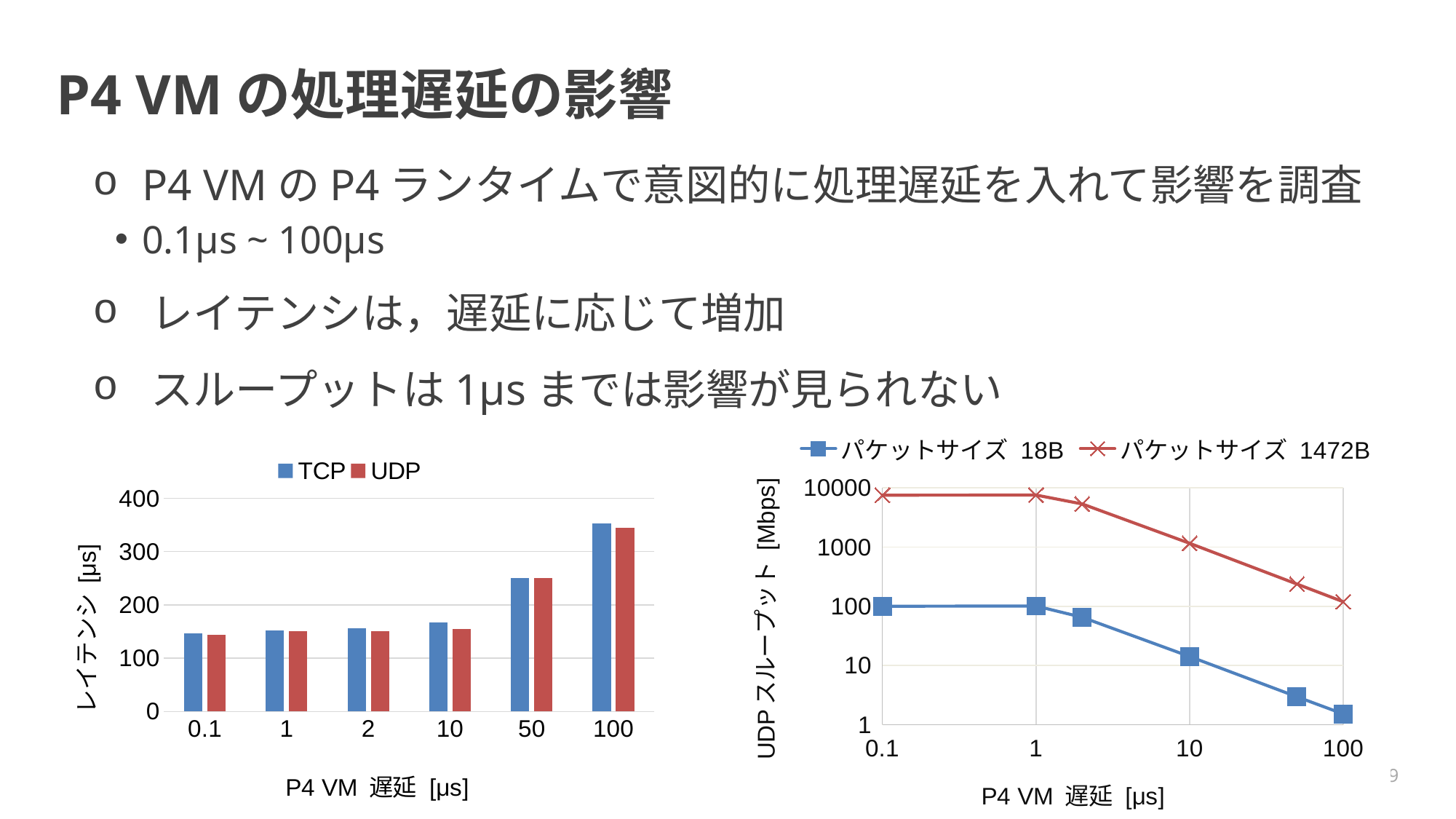
What kind of chart is the right chart showing UDP スループット [Mbps]? line chart In the right throughput chart, what are the two series named in the legend? パケットサイズ 18B and パケットサイズ 1472B In the left latency chart, is the TCP value at 100 μs greater or less than 300? greater In the right throughput chart, does the パケットサイズ 1472B throughput rise or fall as P4 VM 遅延 increases from 1 to 100 μs? fall In the right throughput chart, is the パケットサイズ 18B value at 50 μs greater or less than 10? less In the left latency chart, at which P4 VM 遅延 value is the TCP latency highest? 100 In the left latency chart, is the TCP value at 50 μs greater or less than 200? greater In the right throughput chart, which series has the larger value at 10 μs, パケットサイズ 18B or パケットサイズ 1472B? パケットサイズ 1472B What kind of chart is the left chart showing レイテンシ [μs]? bar chart In the left latency chart, how many P4 VM 遅延 categories are shown on the x axis? 6 In the left latency chart, how many series does the legend list? 2